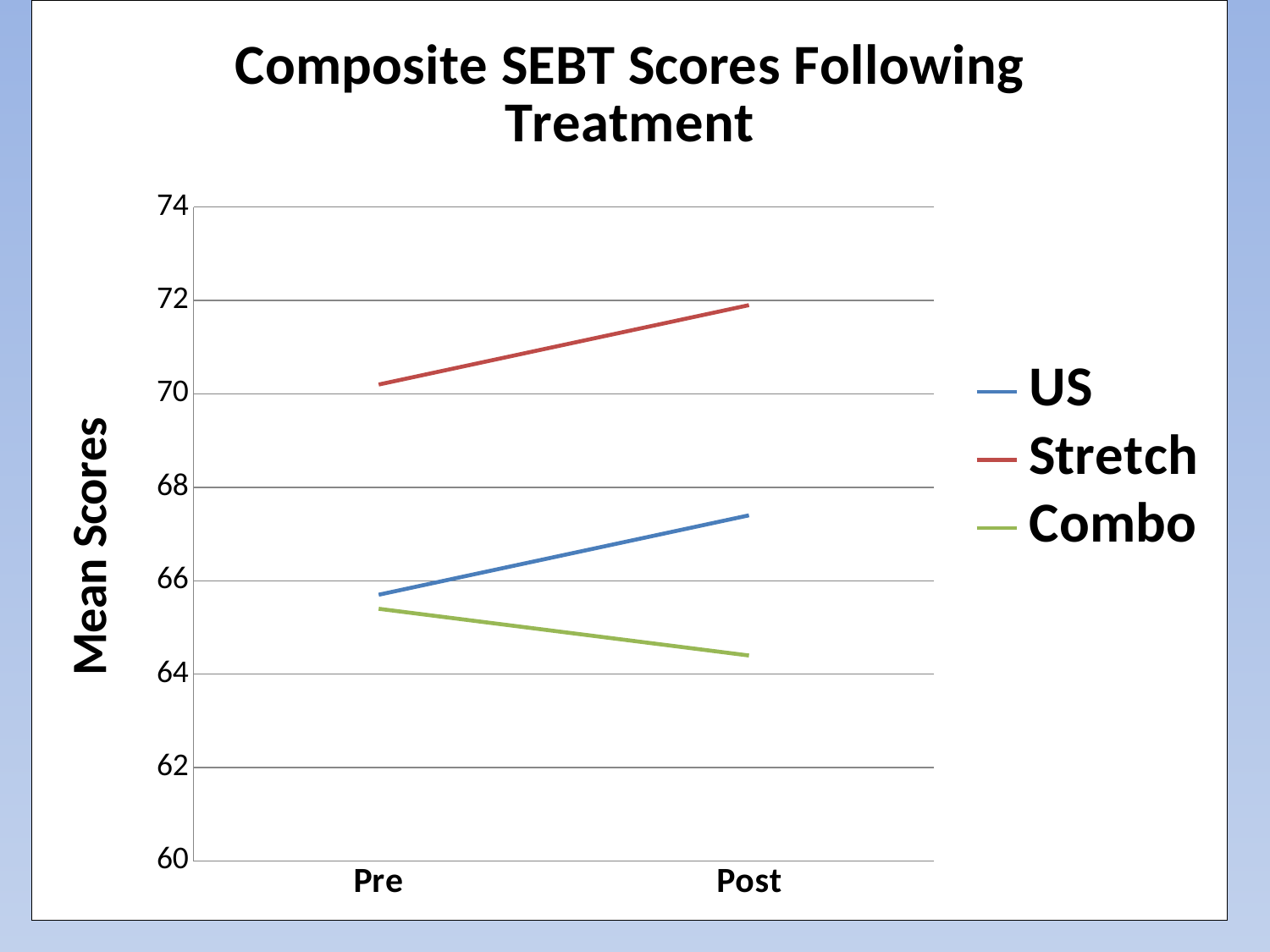
Does the Stretch series rise or fall from Pre to Post? rise At Post, which is larger, the value for US or the value for Combo? US How many series does the legend list? 3 Which series has the highest value at Post? Stretch What kind of chart is shown on the slide? line chart Is the value for Stretch at Post greater or less than 70? greater Is the value for US at Post greater or less than 66? greater Does the Combo series rise or fall from Pre to Post? fall What is the label on the y axis? Mean Scores How many points are there along the x axis? 2 Which series has the lowest value at Post? Combo Is the value for Combo at Post greater or less than 66? less